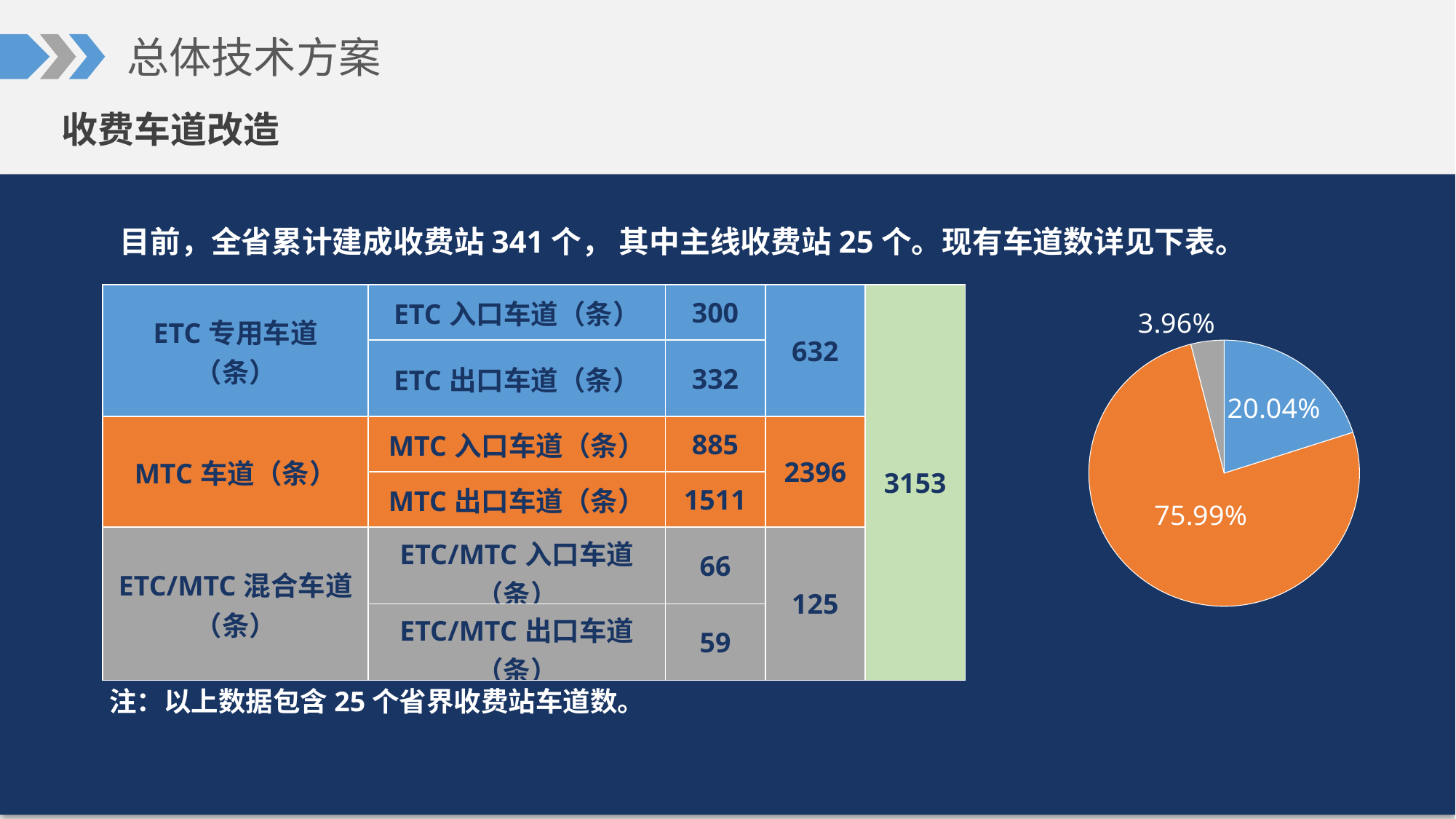
What kind of chart is shown on the right side of the slide? pie chart What percentage is shown on the orange slice of the pie chart? 75.99% Does the pie chart have a legend? No In the pie chart, which is larger, the blue slice or the grey slice? the blue slice What is the difference in percentage points between the orange slice and the blue slice of the pie chart? 55.95 What percentage is shown on the blue slice of the pie chart? 20.04% What percentage is shown on the grey slice of the pie chart? 3.96% What is the difference in percentage points between the blue slice and the grey slice of the pie chart? 16.08 Which slice of the pie chart is the smallest? the grey slice (3.96%) What colour is the largest slice of the pie chart? orange How many slices does the pie chart have? 3 Which slice of the pie chart is the largest? the orange slice (75.99%)